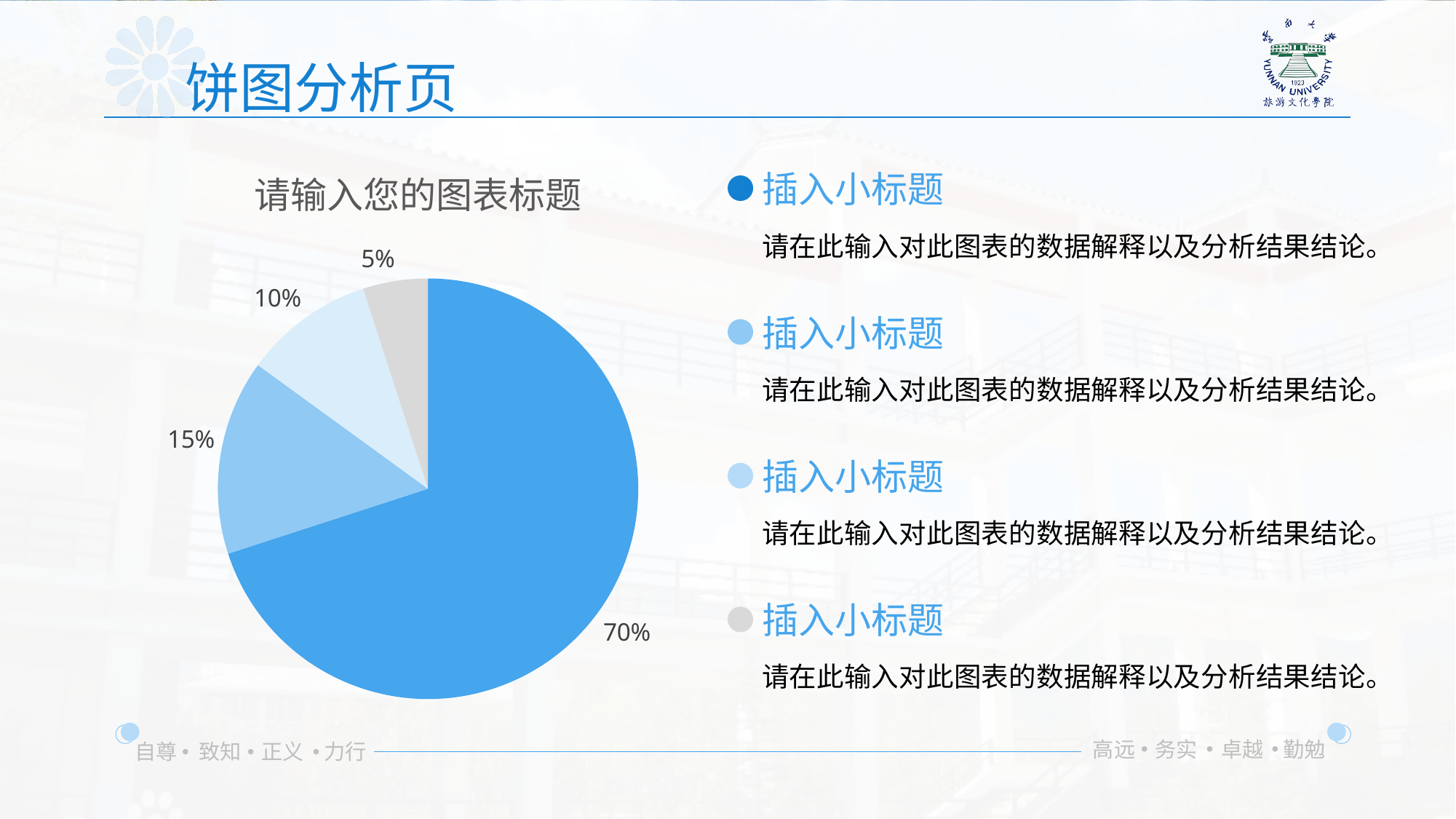
How many slices does the pie chart have? 4 What percentage is shown for the medium-blue slice on the left of the pie chart? 15% What is the difference between the largest slice (70%) and the 15% slice? 55% What is the share of the smallest slice of the pie chart? 5% What colour is the largest slice of the pie chart? blue What is the title of the chart? 请输入您的图表标题 What percentage is shown for the lightest blue slice of the pie chart? 10% What is the combined share of the three smaller slices (15%, 10% and 5%)? 30% Which slice is larger, the 10% slice or the 5% slice? the 10% slice What is the share of the largest slice of the pie chart? 70% What kind of chart is shown on the slide? pie chart What percentage is shown for the grey slice of the pie chart? 5%